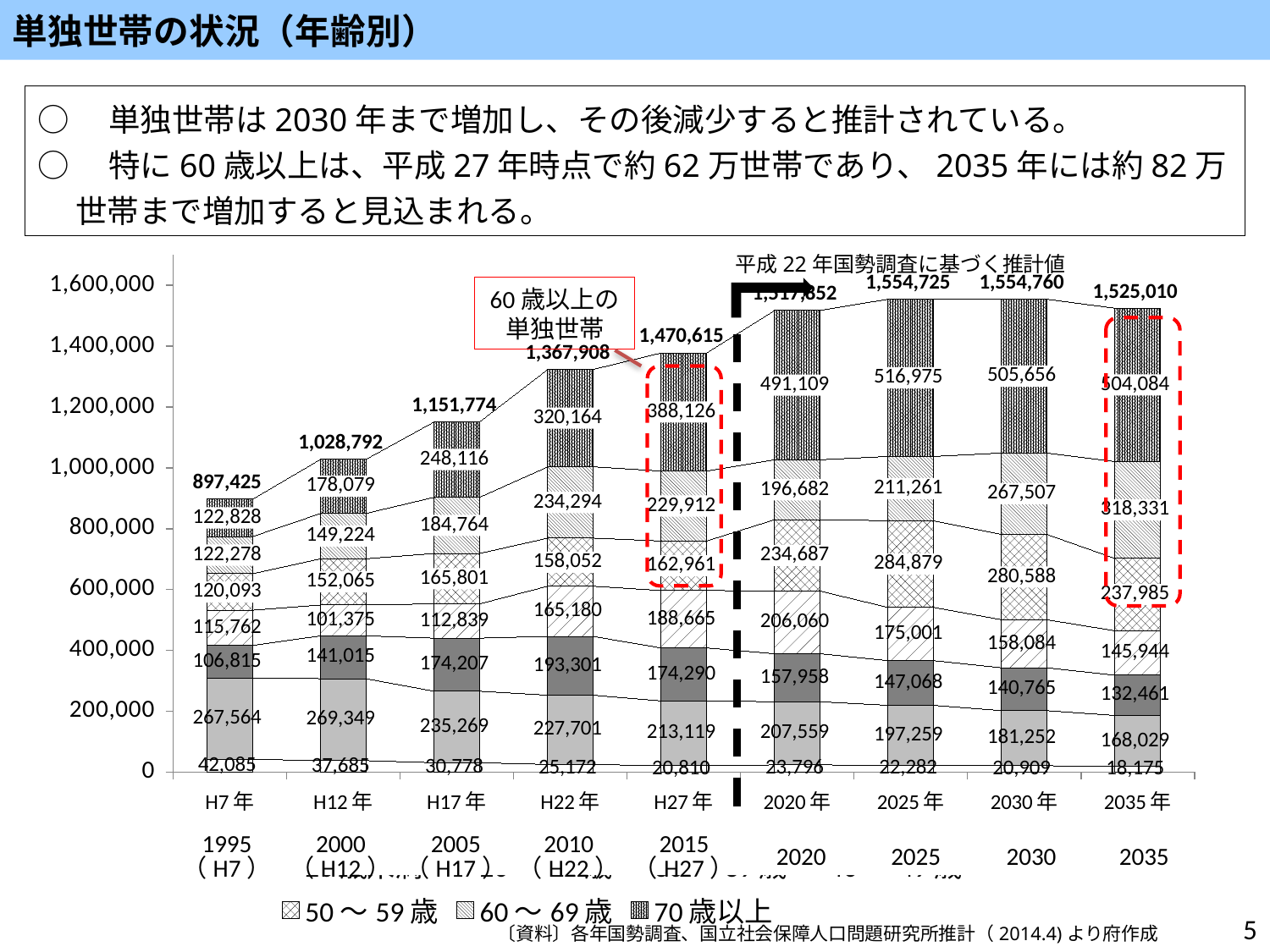
What kind of chart is shown on the slide? Stacked bar chart Which is larger, the 70歳以上 segment for 2035年 or for 2020年? 2035年 How many years (bars) are shown on the x axis? 9 What is the difference between the total for 2035年 and the total for H27年? 54,395 Is the total for H17年 greater or less than 1,200,000? less What is the total number of single-person households shown for H7年? 897,425 Which year has the lowest total number of single-person households? H7年 What is the value of the 70歳以上 segment for H27年? 388,126 What is the total number of single-person households shown for 2035年? 1,525,010 Do the bar totals rise or fall from H7年 to 2030年? Rise By how much does the 70歳以上 segment in 2035年 exceed the 70歳以上 segment in H27年? 115,958 What is the value of the 70歳以上 segment for 2035年? 504,084